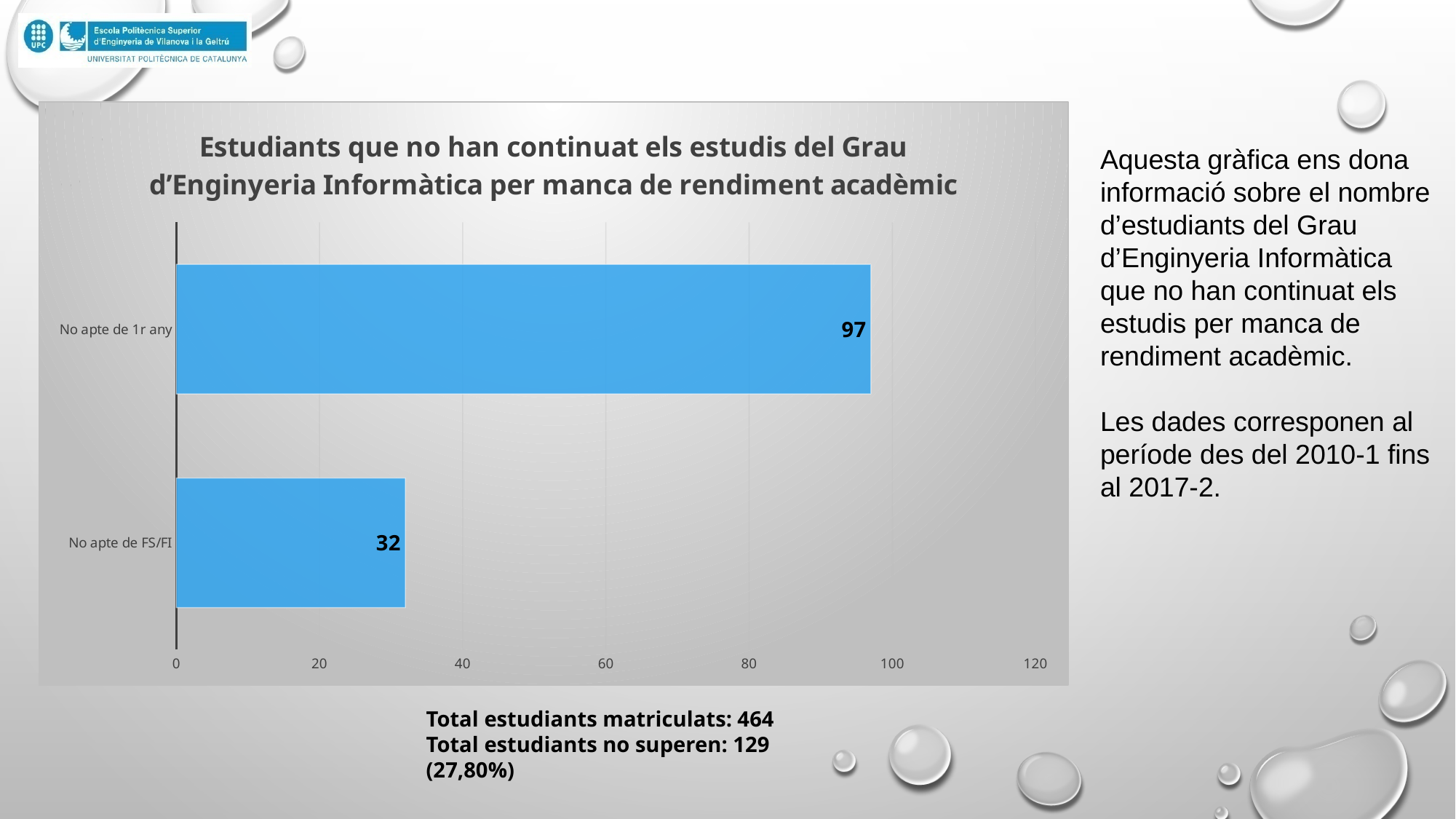
Which category has the highest value? No apte de 1r any Which is larger, the value for "No apte de 1r any" or the value for "No apte de FS/FI"? No apte de 1r any What is the value for "No apte de FS/FI"? 32 Which category has the lowest value? No apte de FS/FI Is the value for "No apte de FS/FI" greater or less than 40? less What is the highest value shown on the x axis of the chart? 120 What is the difference between the values for "No apte de 1r any" and "No apte de FS/FI"? 65 How many categories are shown in the chart? 2 What kind of chart is shown on the slide? bar chart Is the value for "No apte de 1r any" greater or less than 80? greater What is the title of the chart? Estudiants que no han continuat els estudis del Grau d'Enginyeria Informàtica per manca de rendiment acadèmic What is the value for "No apte de 1r any"? 97